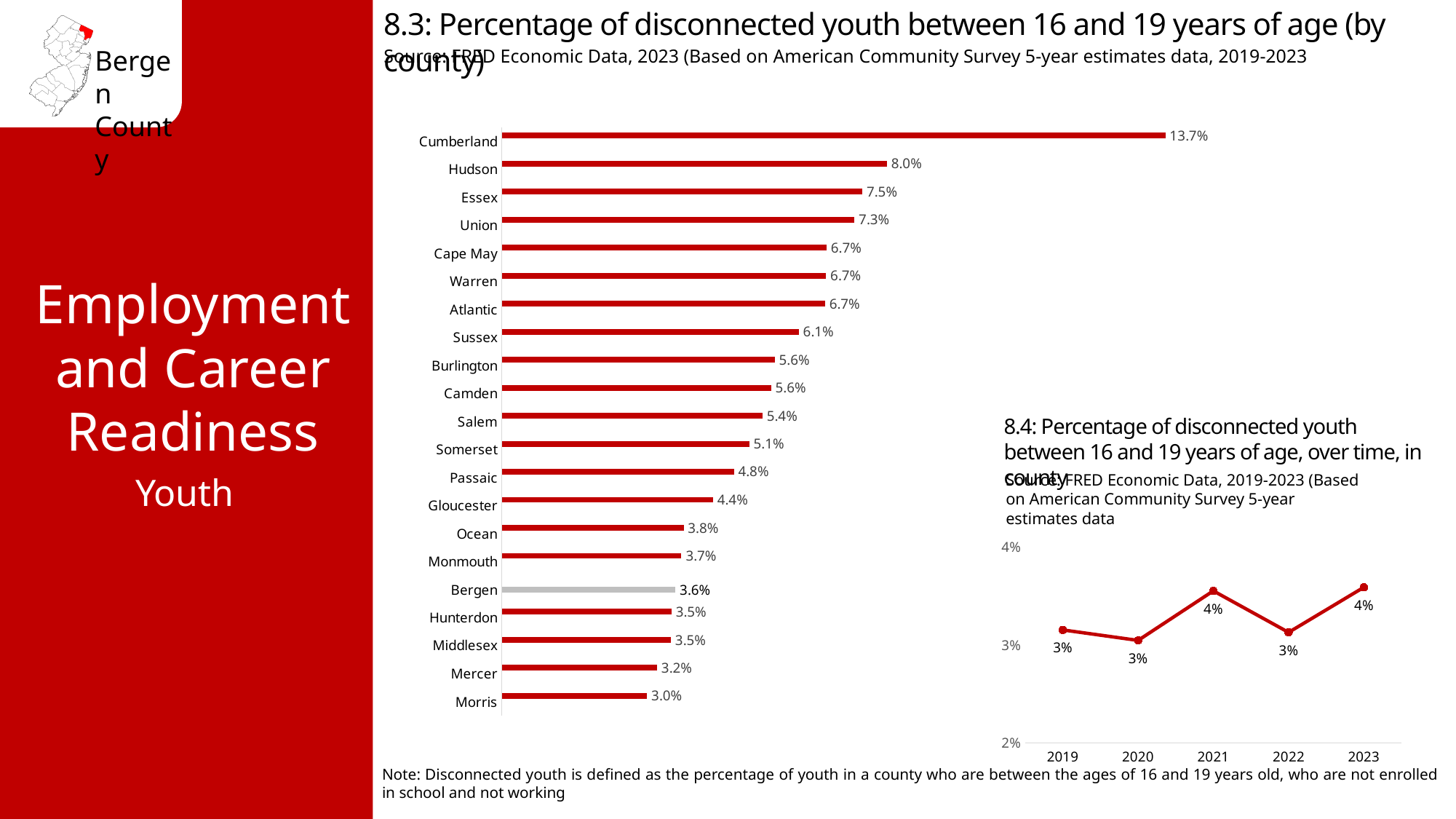
In chart 8.3 (percentage of disconnected youth by county), what is the value for Cumberland? 13.7% In chart 8.3 (percentage of disconnected youth by county), how many counties are shown? 21 In chart 8.3 (percentage of disconnected youth by county), which bar is coloured grey instead of red? Bergen In chart 8.4 (disconnected youth over time in county), does the value rise or fall from 2020 to 2021? Rise In chart 8.3 (percentage of disconnected youth by county), which county has the lowest percentage? Morris In chart 8.4 (disconnected youth over time in county), how many years are plotted? 5 In chart 8.4 (disconnected youth over time in county), what is the value labelled for 2021? 4% What kind of chart is chart 8.3 (percentage of disconnected youth by county)? Bar chart In chart 8.3 (percentage of disconnected youth by county), what is the value for Bergen? 3.6% In chart 8.3 (percentage of disconnected youth by county), which is larger, the value for Essex or the value for Passaic? Essex In chart 8.3 (percentage of disconnected youth by county), which county has the highest percentage? Cumberland In chart 8.3 (percentage of disconnected youth by county), what is the difference between Cumberland and Hudson? 5.7%